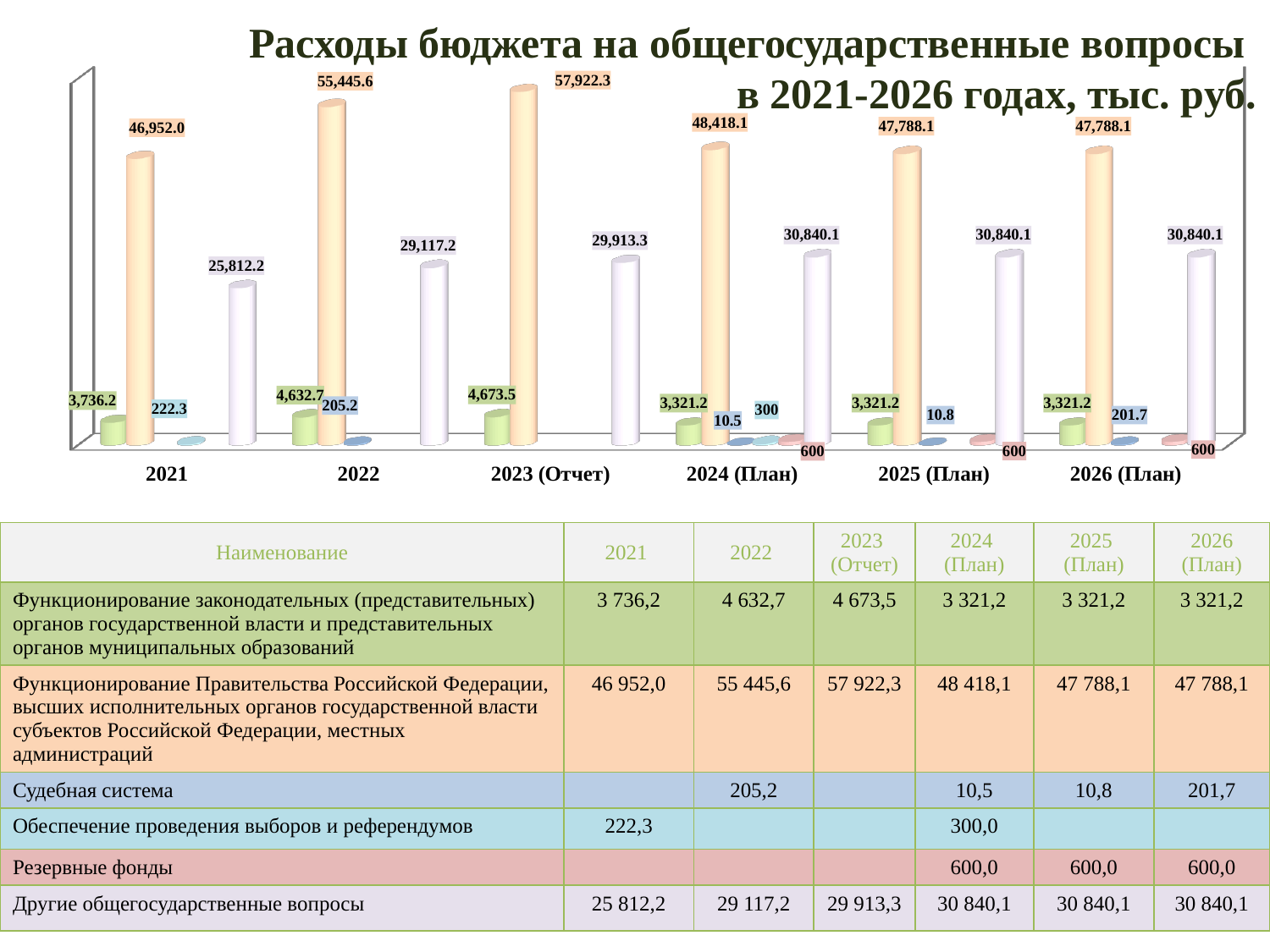
What is the value of the tallest bar in the 2023 (Отчет) group? 57,922.3 Which is larger: the green bar in 2022 (4,632.7) or the green bar in 2023 (Отчет) (4,673.5)? 2023 (Отчет) In which year does the series for Функционирование Правительства Российской Федерации reach its highest value? 2023 (Отчет) What is the title of the chart? Расходы бюджета на общегосударственные вопросы в 2021-2026 годах, тыс. руб. Do the values for Другие общегосударственные вопросы rise or fall from 2021 to 2024 (План)? rise How many year categories are shown along the x axis of the chart? 6 What is the value labelled for Другие общегосударственные вопросы in 2021? 25,812.2 What is the value labelled for Резервные фонды in 2024 (План)? 600 What is the value labelled for Судебная система in 2026 (План)? 201.7 What kind of chart is shown on the slide? bar chart What is the smallest labelled value in the 2024 (План) group? 10.5 What is the difference between the tallest bar in 2023 (Отчет) (57,922.3) and the tallest bar in 2022 (55,445.6)? 2,476.7